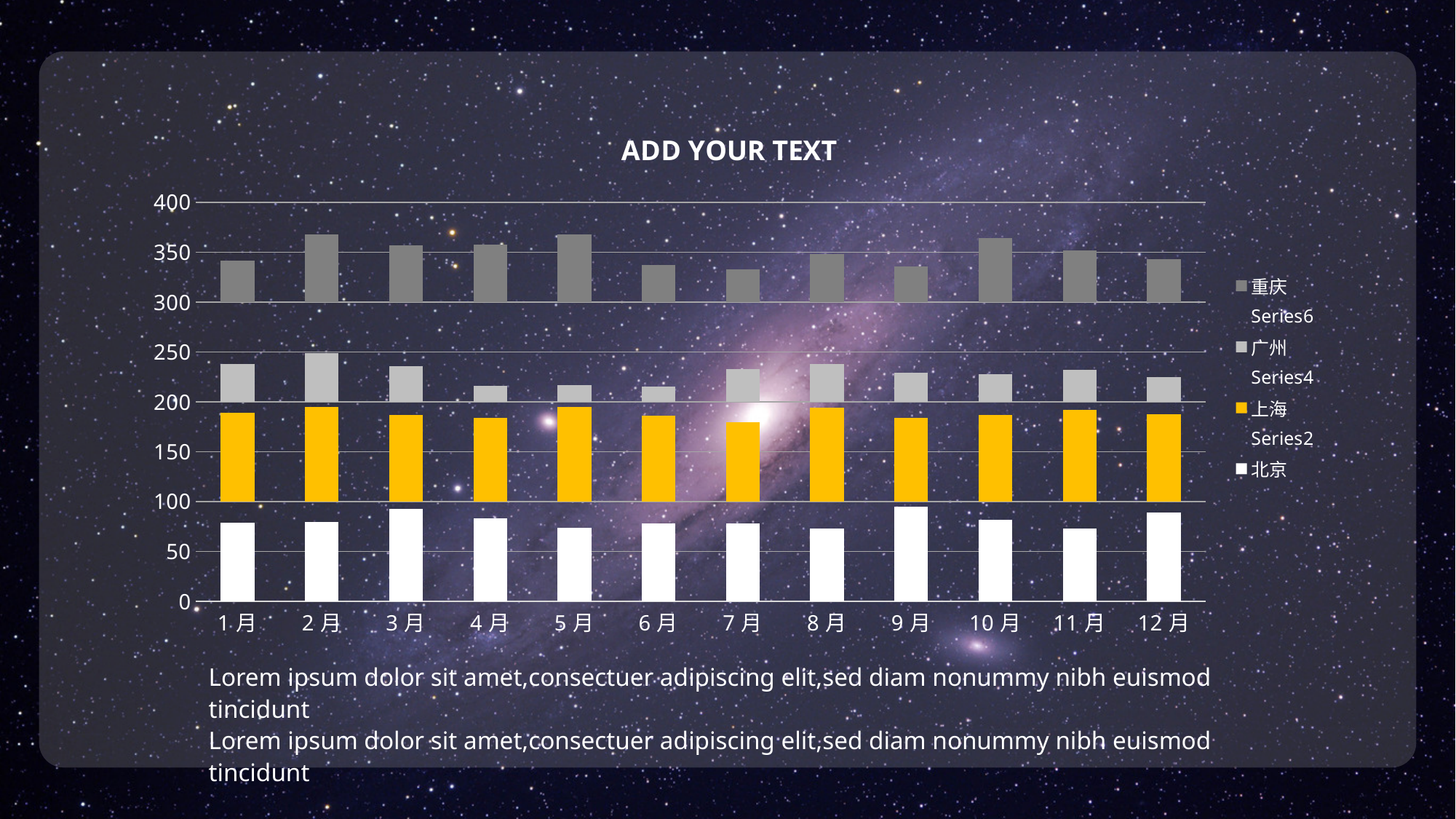
Which is taller, the 重庆 bar in 2月 or the 重庆 bar in 7月? 2月 Which month has the tallest 广州 bar? 2月 Is the top of the 重庆 bar in 2月 greater or less than 350? greater Is the top of the 上海 bar in 7月 greater or less than 150? greater How many entries does the chart legend list? 7 Is the top of the 北京 bar in 1月 greater or less than 100? less How many months are shown along the x axis? 12 What colour are the bars for 上海? yellow What is the title of the chart? ADD YOUR TEXT What kind of chart is shown on the slide? bar chart